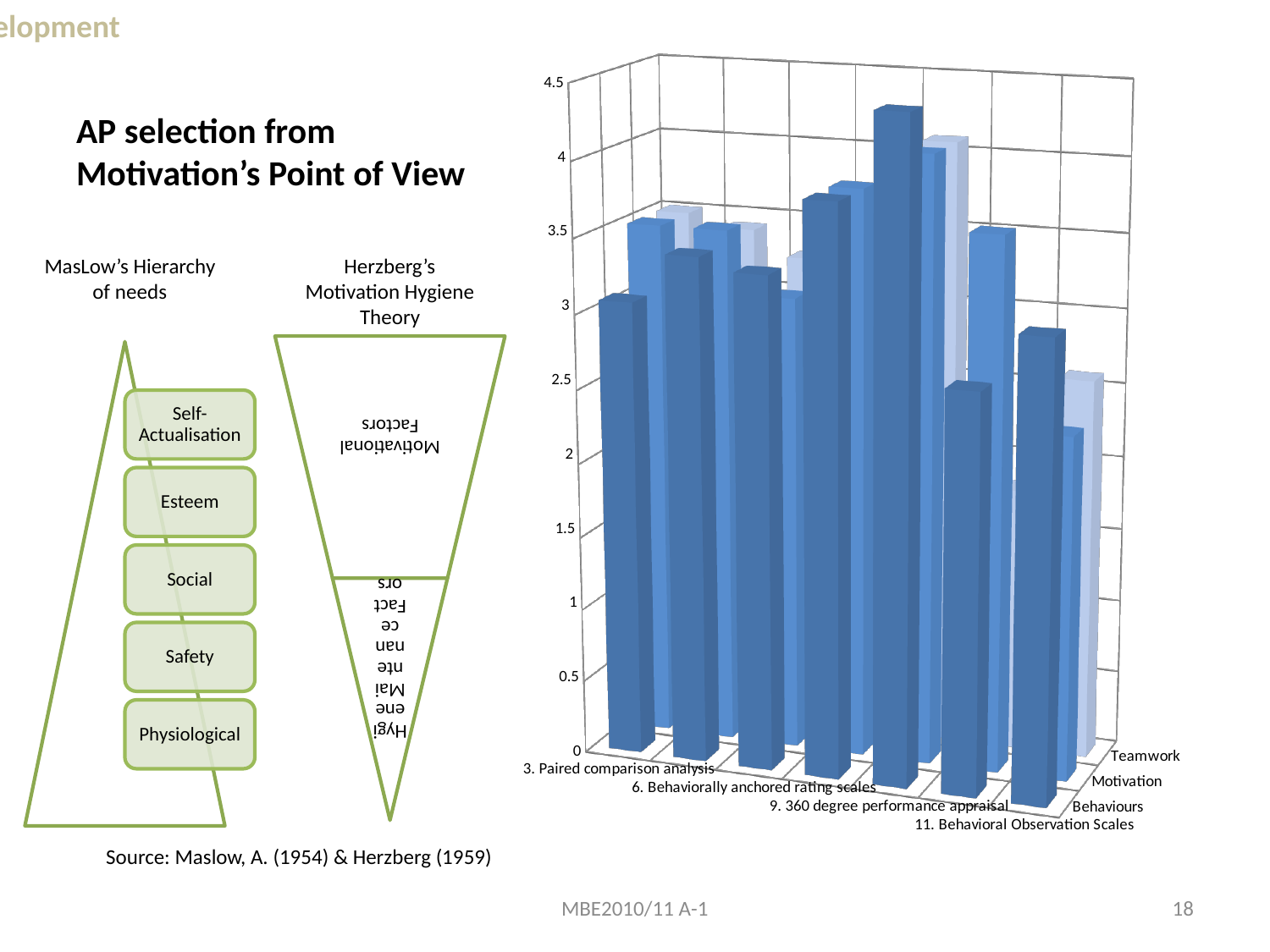
Is the front-row bar for '3. Paired comparison analysis' greater or less than 2? greater What kind of chart is shown on the right side of the slide? bar chart Is the tallest bar in the chart greater or less than 3.5? greater What are the three series labels shown along the depth axis of the bar chart? Teamwork, Motivation, Behaviours Is the front-row bar for '3. Paired comparison analysis' greater or less than 4? less What is the maximum value shown on the vertical axis of the bar chart? 4.5